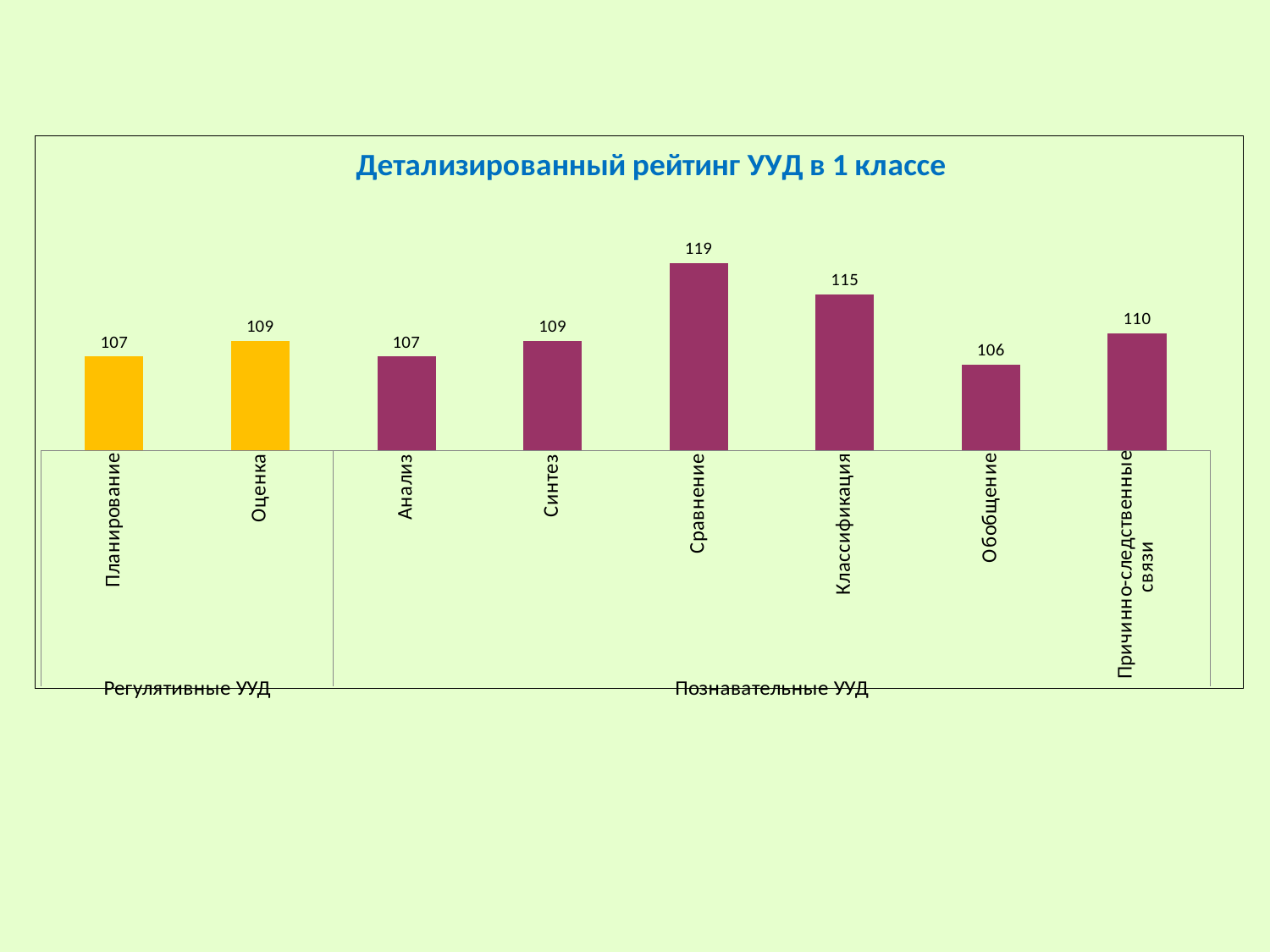
What is the value for Планирование? 107 What is the value for Сравнение? 119 Which category has the highest value? Сравнение Which category has the lowest value? Обобщение What is the difference between the values for Сравнение and Классификация? 4 What is the title of the chart? Детализированный рейтинг УУД в 1 классе How many categories are shown in the chart? 8 What is the difference between the values for Оценка and Планирование? 2 Which is larger, the value for Классификация or the value for Синтез? Классификация What kind of chart is this? Bar chart What is the value for Причинно-следственные связи? 110 What is the value for Обобщение? 106